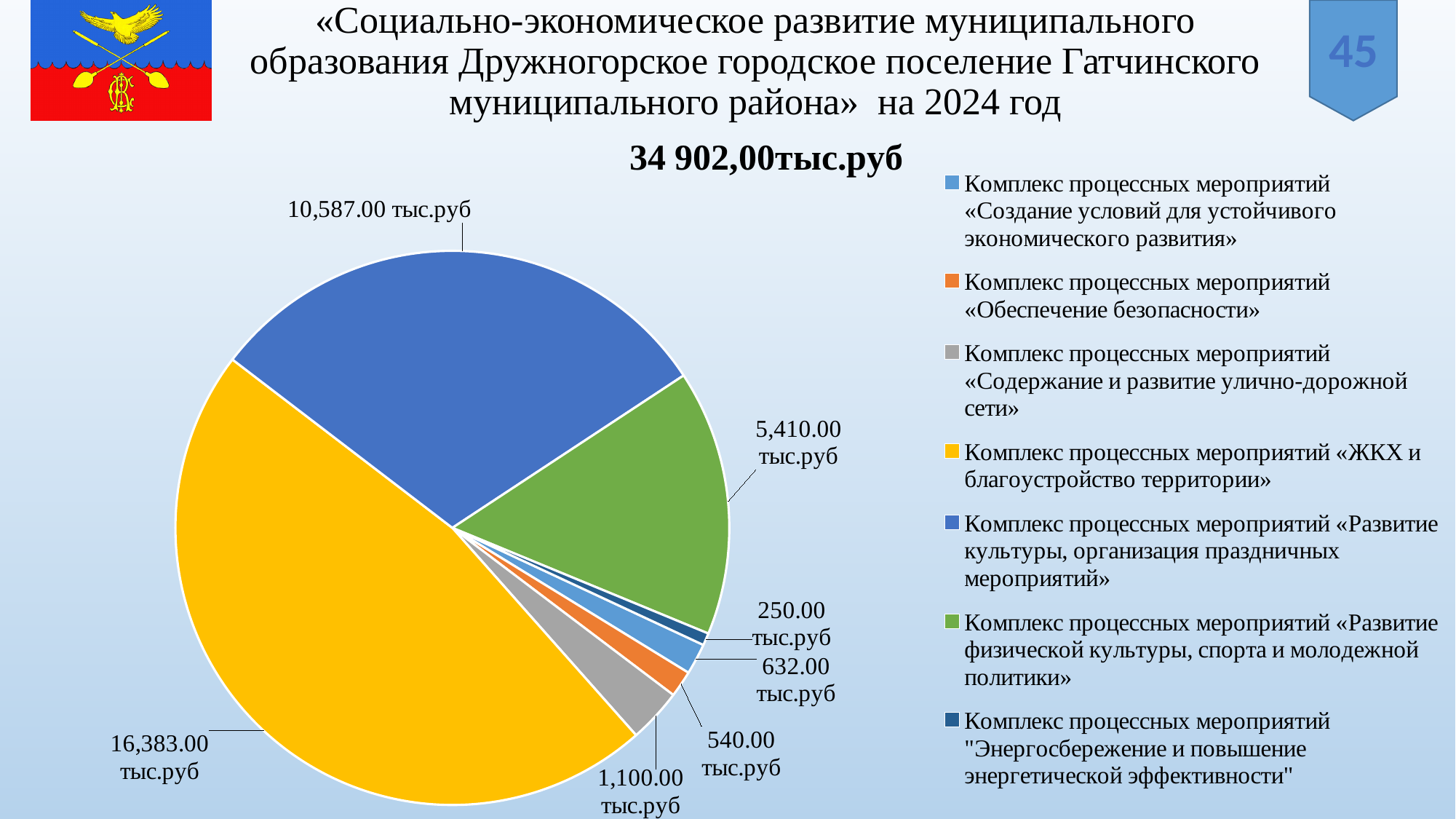
Which category has the largest slice of the pie? Комплекс процессных мероприятий «ЖКХ и благоустройство территории» How many entries does the legend list? 7 What is the value for «ЖКХ и благоустройство территории»? 16,383.00 тыс.руб What total amount is shown in the chart title? 34 902,00тыс.руб What is the value for «Содержание и развитие улично-дорожной сети»? 1,100.00 тыс.руб What is the value for «Развитие культуры, организация праздничных мероприятий»? 10,587.00 тыс.руб Which category has the smallest slice of the pie? Комплекс процессных мероприятий "Энергосбережение и повышение энергетической эффективности" How many slices does the pie chart have? 7 What kind of chart is shown on the slide? pie chart Which is larger: the value for «Создание условий для устойчивого экономического развития» or for «Обеспечение безопасности»? «Создание условий для устойчивого экономического развития» What is the value for «Развитие физической культуры, спорта и молодежной политики»? 5,410.00 тыс.руб What is the difference between the values for «ЖКХ и благоустройство территории» and «Развитие культуры, организация праздничных мероприятий»? 5,796.00 тыс.руб